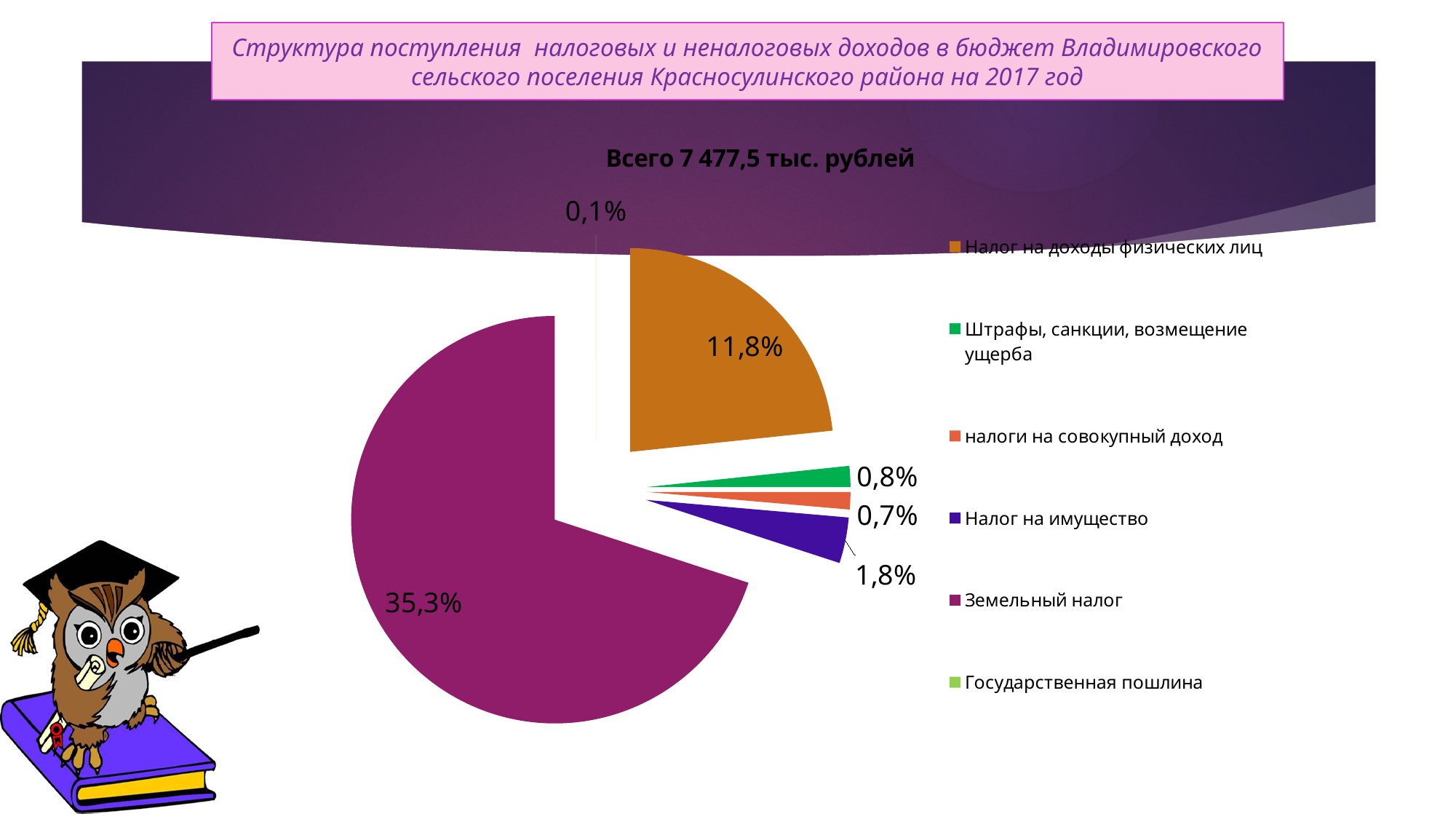
What is the value shown for Государственная пошлина? 0,1% What is the value shown for Штрафы, санкции, возмещение ущерба? 0,8% How many categories does the legend list? 6 What is the value shown for Земельный налог? 35,3% Which category has the largest slice of the pie? Земельный налог Which is larger, Налог на имущество or Штрафы, санкции, возмещение ущерба? Налог на имущество What is the value shown for Налог на доходы физических лиц? 11,8% What kind of chart is shown on the slide? Pie chart Which category has the smallest slice of the pie? Государственная пошлина What is the value shown for налоги на совокупный доход? 0,7% What total amount is stated in the chart title? 7 477,5 тыс. рублей What is the value shown for Налог на имущество? 1,8%